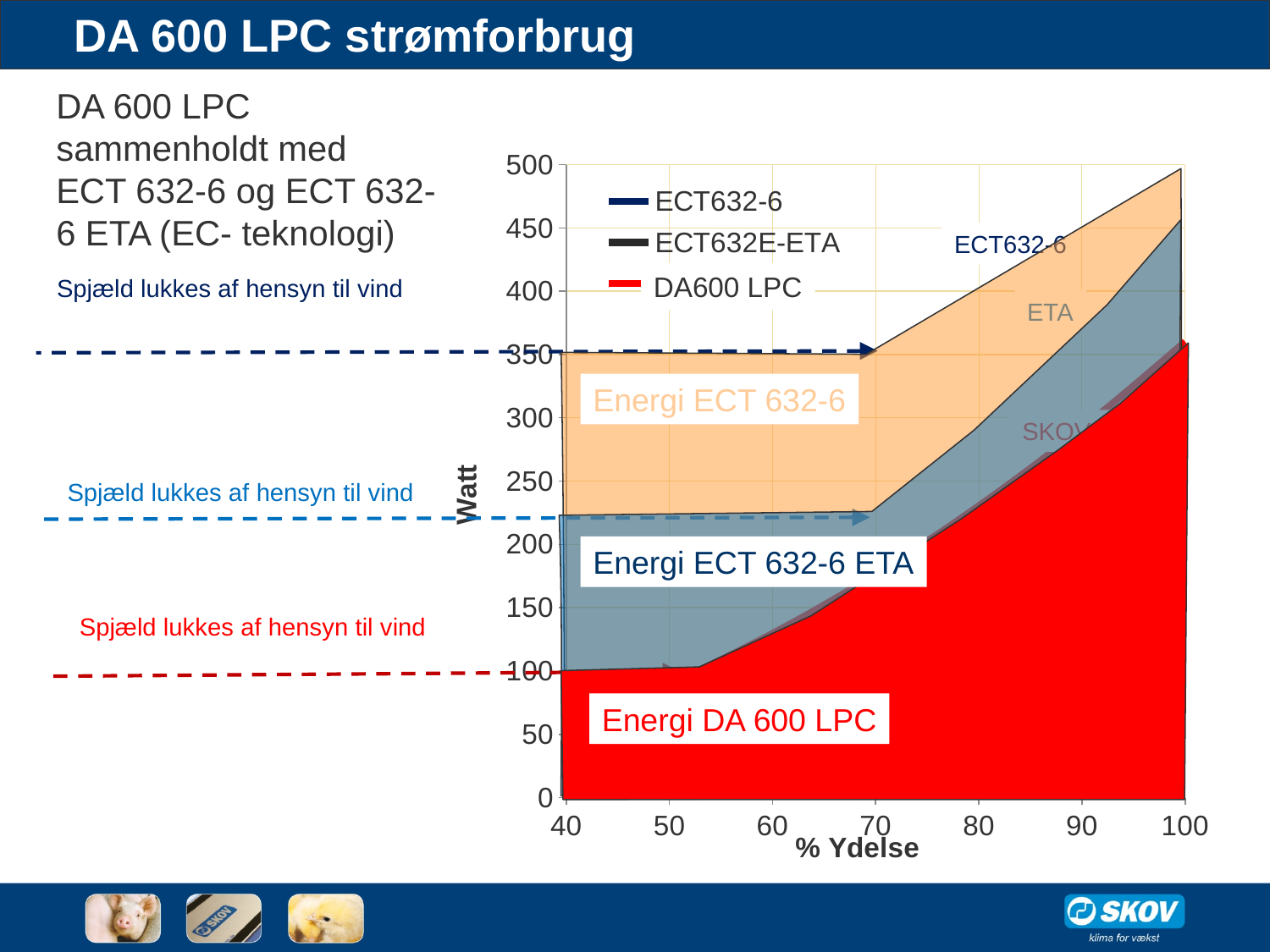
Is the value for ECT632-6 at 40 % Ydelse greater or less than 300 Watt? greater What is the label of the vertical axis of the chart? Watt What kind of chart is shown on the slide? area chart Is the value for ECT632-6 at 100 % Ydelse greater or less than 450 Watt? greater Which series has the lowest value at 100 % Ydelse? DA600 LPC Is the value for DA600 LPC at 100 % Ydelse greater or less than 400 Watt? less How many series does the chart legend list? 3 At 100 % Ydelse, which is larger: the value for ECT632E-ETA or the value for DA600 LPC? ECT632E-ETA Which series has the highest value at 100 % Ydelse? ECT632-6 Do the values for DA600 LPC rise or fall as % Ydelse increases from 70 to 100? rise